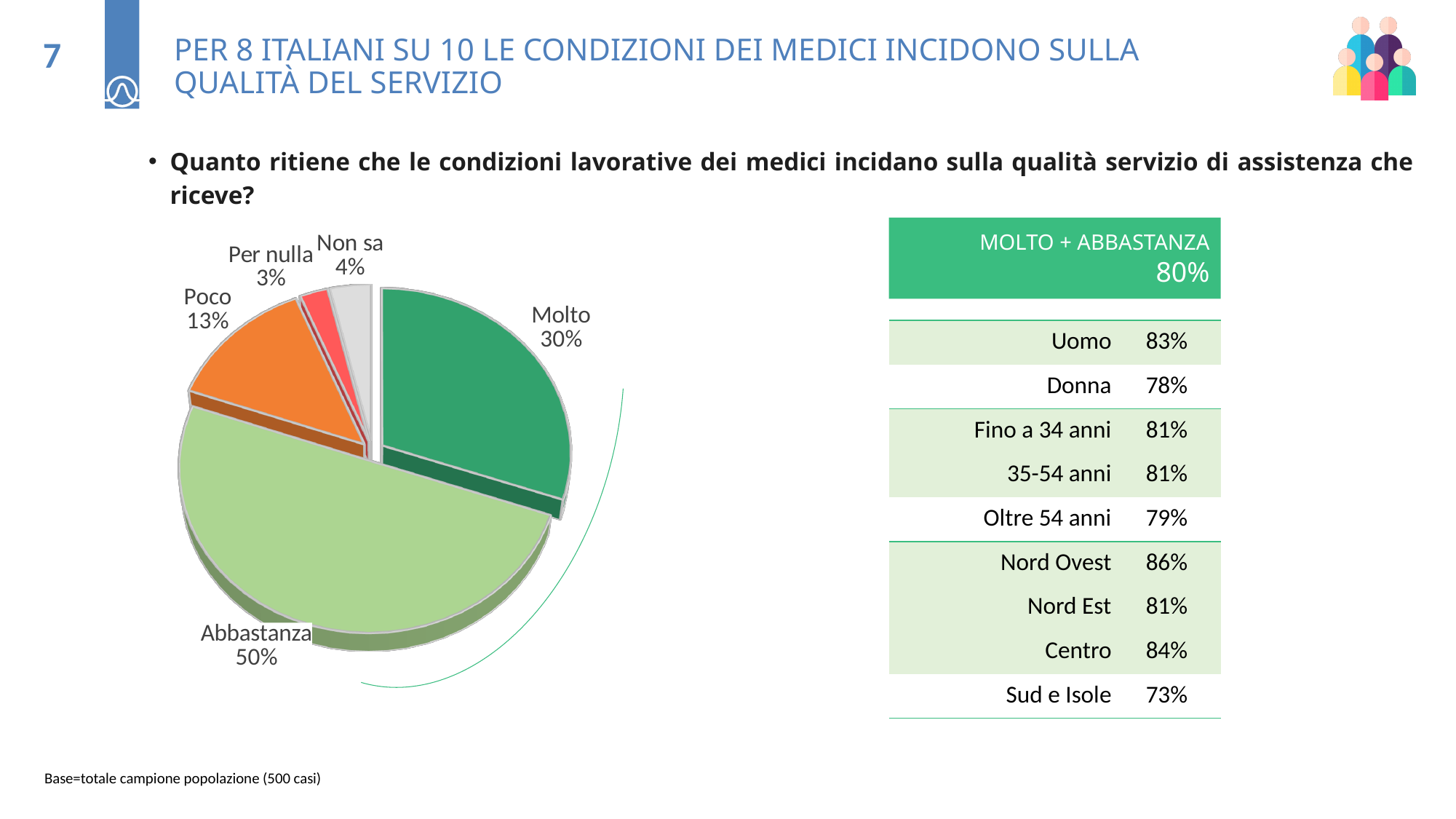
What percentage of respondents answered "Poco" in the pie chart? 13% What percentage of respondents answered "Molto" in the pie chart? 30% What is the combined share of the "Molto" and "Abbastanza" slices in the pie chart? 80% What percentage of respondents answered "Abbastanza" in the pie chart? 50% What type of chart is shown on the slide? Pie chart Which response category has the smallest slice in the pie chart? Per nulla What is the difference in percentage points between the "Abbastanza" and "Molto" slices? 20 Which slice is larger in the pie chart, "Poco" or "Non sa"? Poco Which response category has the largest slice in the pie chart? Abbastanza How many slices does the pie chart have? 5 What colour is the "Poco" slice in the pie chart? Orange What percentage of respondents answered "Non sa" in the pie chart? 4%